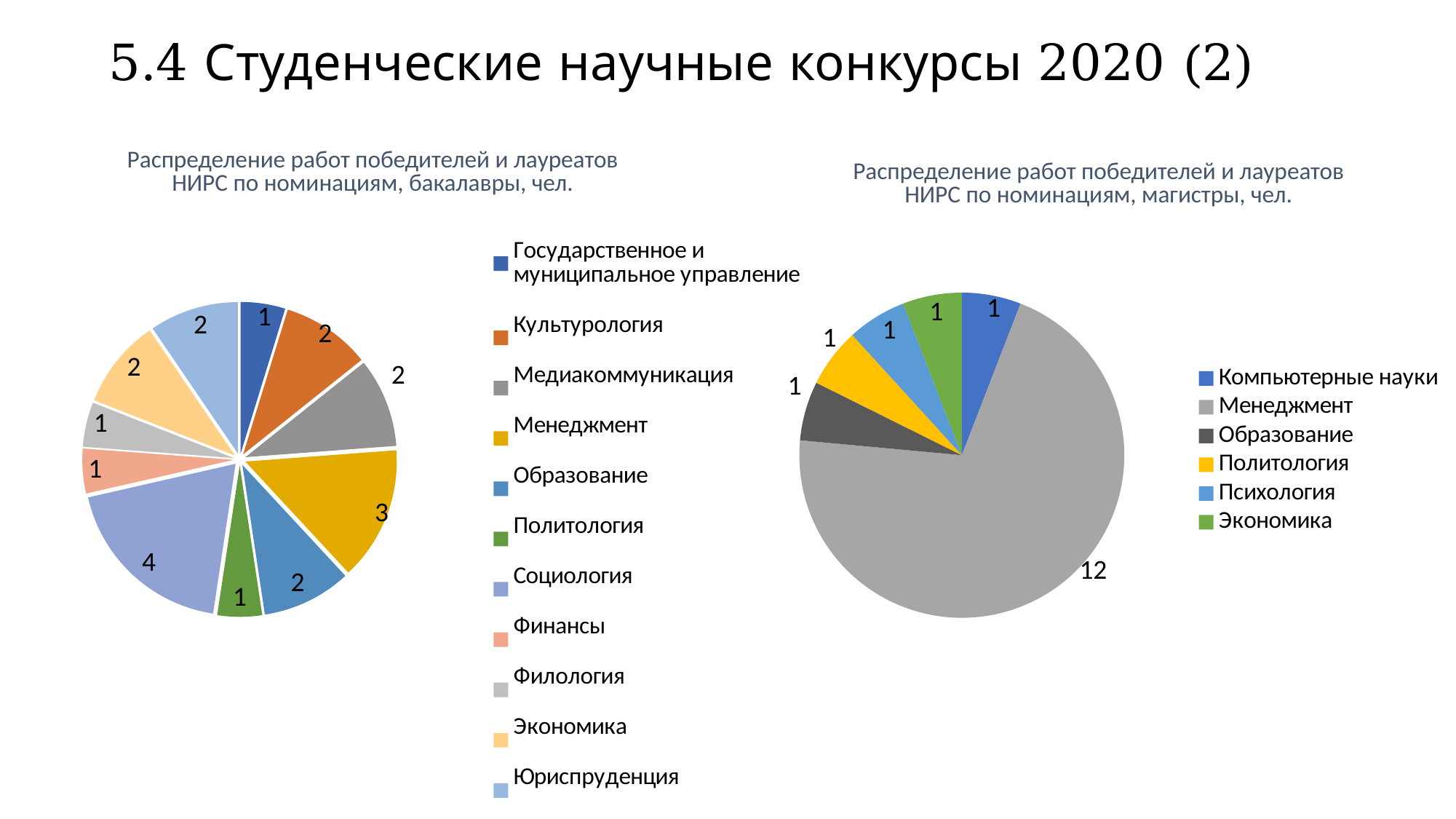
In the right chart (магистры), what is the value for Менеджмент? 12 In the left chart (бакалавры), how many categories does the legend list? 11 In the left chart (бакалавры), which category has the largest slice? Социология In the left chart (бакалавры), what is the value for Социология? 4 In the right chart (магистры), what is the total of all slices? 17 In the right chart (магистры), which category has the largest slice? Менеджмент In the right chart (магистры), what colour is the Менеджмент slice? Grey What kind of chart is the left chart, 'Распределение работ победителей и лауреатов НИРС по номинациям, бакалавры, чел.'? Pie chart In the left chart (бакалавры), what is the value for Менеджмент? 3 In the left chart (бакалавры), which is larger, Культурология or Финансы? Культурология In the right chart (магистры), how many categories does the legend list? 6 In the left chart (бакалавры), what is the difference between Социология and Менеджмент? 1